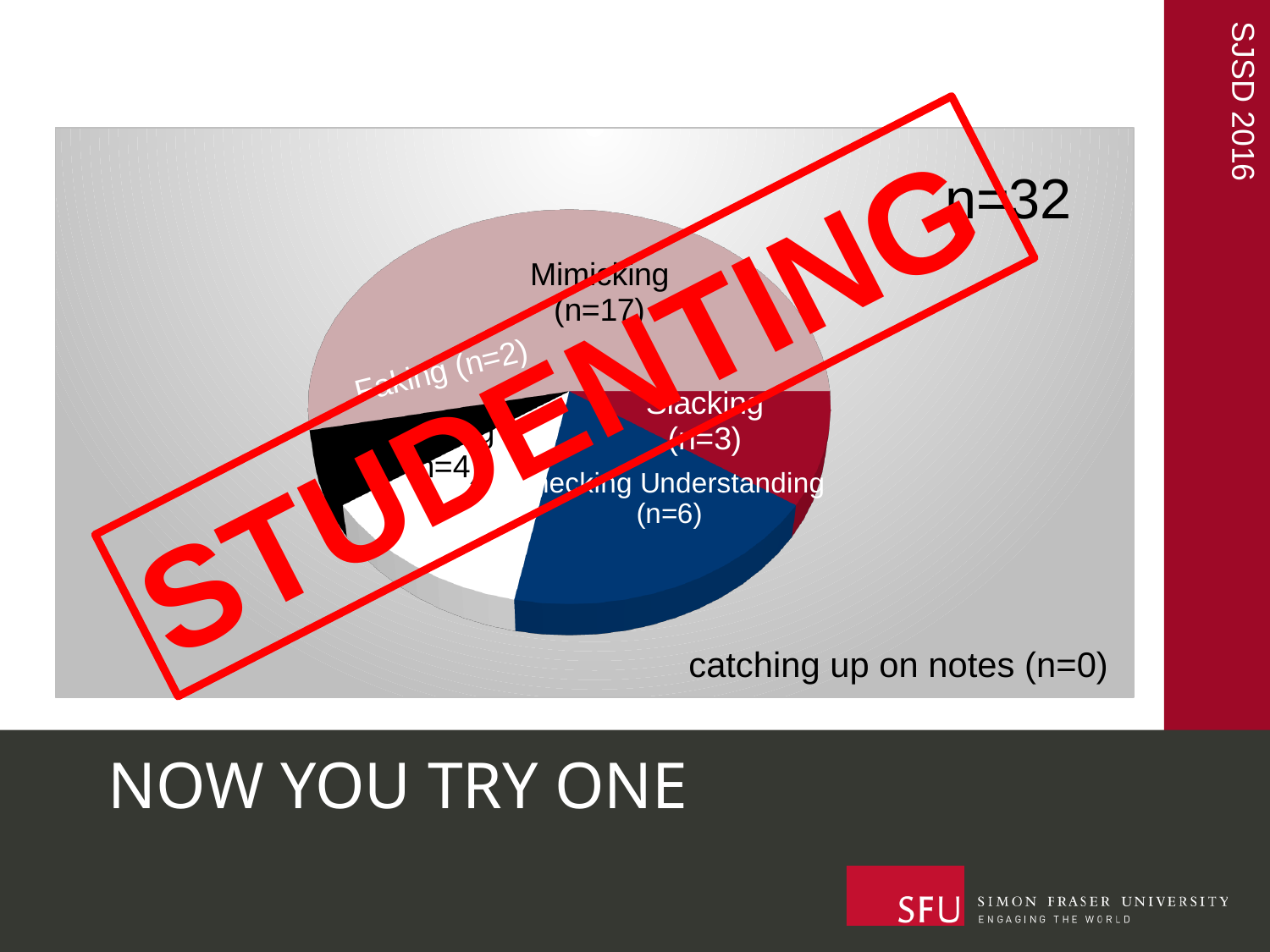
Which is larger, the count for Checking Understanding or the count for Slacking? Checking Understanding What is the value shown for 'catching up on notes'? n=0 Which category has the smallest value in the pie chart? catching up on notes What is the value shown for the Faking slice? n=2 What is the total sample size (n) shown in the top right of the chart? n=32 What is the value shown for the Checking Understanding slice? n=6 What kind of chart is shown on the slide? Pie chart Which category has the largest value in the pie chart? Mimicking What is the value shown for the Mimicking slice of the pie chart? n=17 How much larger is the Mimicking count than the Checking Understanding count? 11 What word is stamped diagonally across the chart in red? STUDENTING What is the value shown for the Slacking slice? n=3